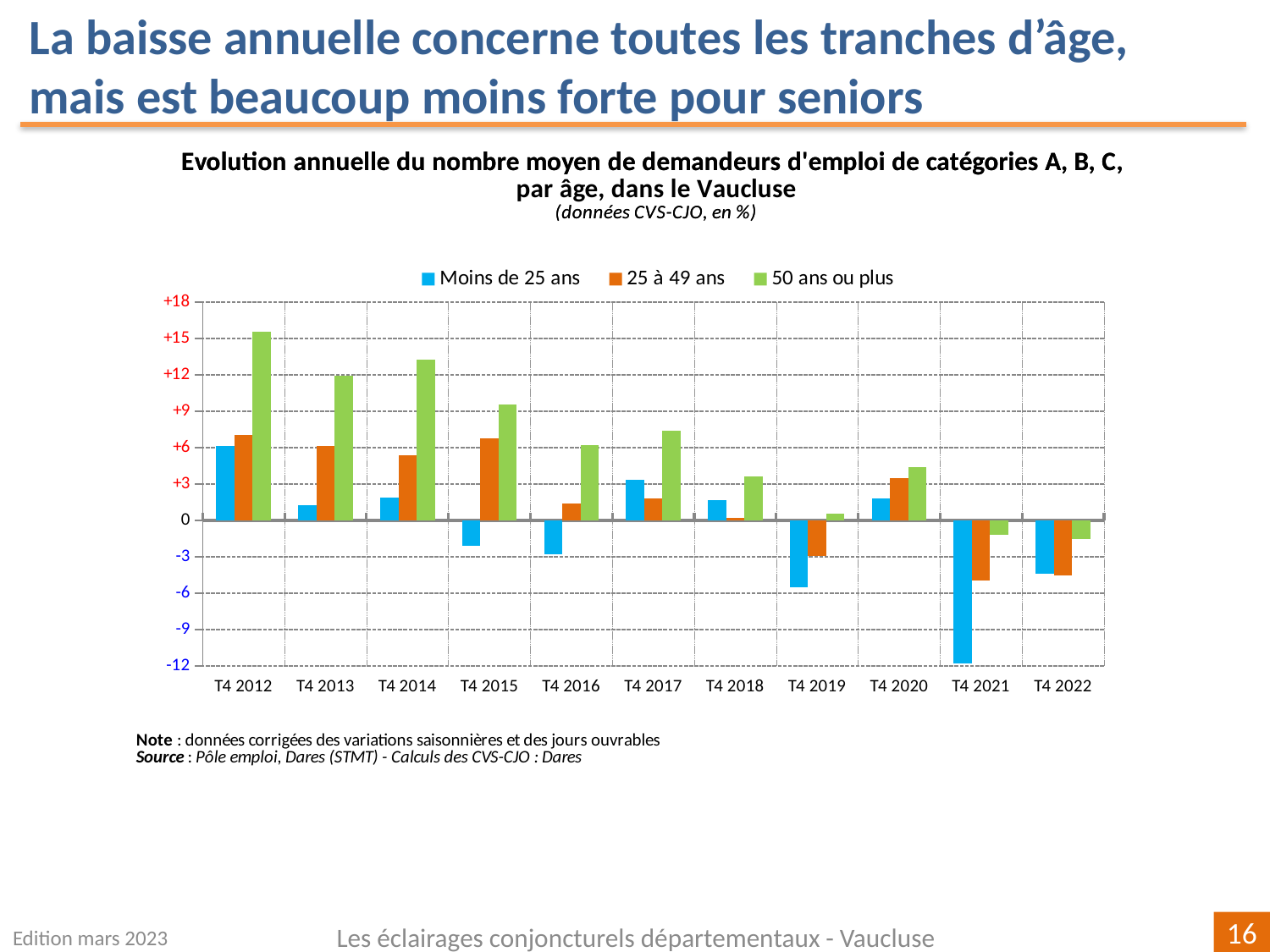
For the series '50 ans ou plus', which quarter has the highest value? T4 2012 For the series 'Moins de 25 ans', which quarter has the lowest value? T4 2021 Is the value for 'Moins de 25 ans' in T4 2021 greater or less than -9? less Is the value for '25 à 49 ans' in T4 2021 greater or less than -3? less What kind of chart is shown on the slide? Bar chart In T4 2012, which series has the larger value: 'Moins de 25 ans' or '50 ans ou plus'? 50 ans ou plus In T4 2019, which series has the larger value: 'Moins de 25 ans' or '25 à 49 ans'? 25 à 49 ans Is the value for '50 ans ou plus' in T4 2012 greater or less than +12? greater Overall, do the values for '50 ans ou plus' rise or fall from T4 2012 to T4 2022? fall What colour represents the series '50 ans ou plus' in the legend? Green How many quarters (categories) are shown on the x axis? 11 How many series does the legend list? 3